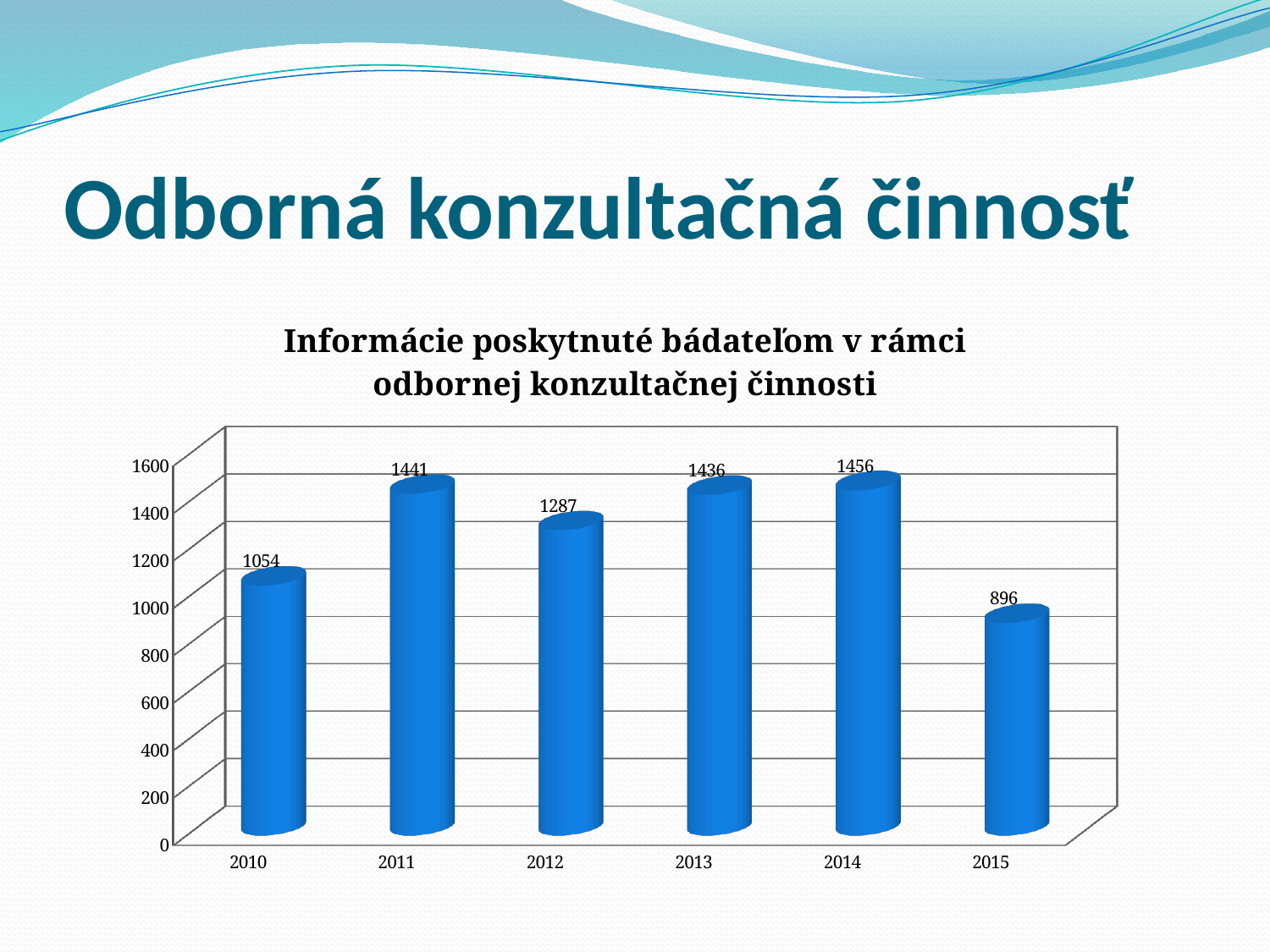
Which year has the lowest value? 2015 What is the difference between the values for 2014 and 2015? 560 What kind of chart is shown on the slide? bar chart What is the value for 2015? 896 Is the value for 2015 greater or less than 1000? less How many years are shown on the x axis? 6 What is the title of the chart? Informácie poskytnuté bádateľom v rámci odbornej konzultačnej činnosti What is the value for 2010? 1054 Which is larger, the value for 2012 or the value for 2013? 2013 What is the value for 2012? 1287 What is the difference between the values for 2011 and 2010? 387 Which year has the highest value? 2014